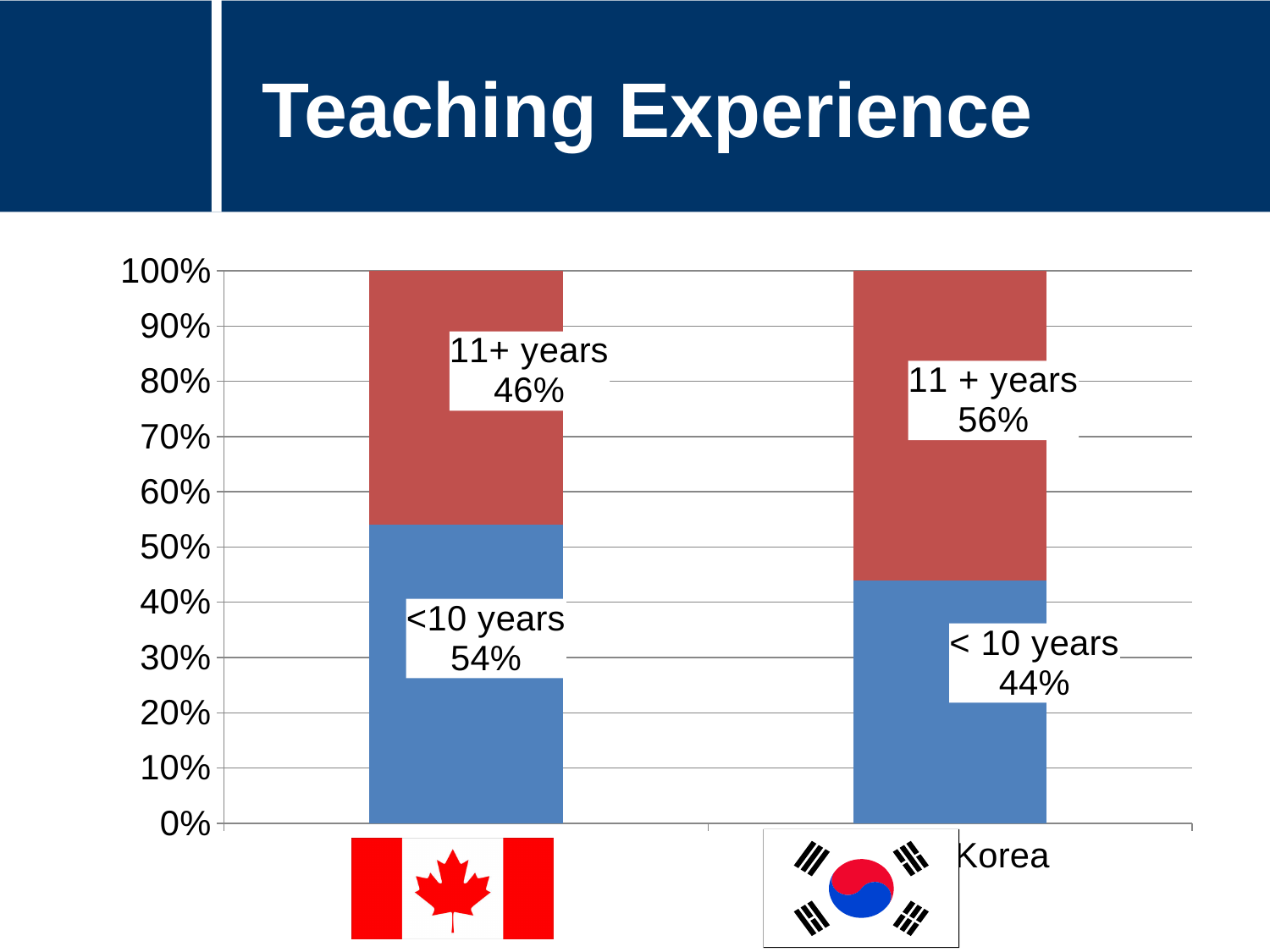
What is the difference between the '11 + years' share for Korea and the '11+ years' share for the left bar (Canadian flag)? 10% What is the title of the slide? Teaching Experience What percentage of the left bar (with the Canadian flag) is labelled '<10 years'? 54% What percentage of the Korea bar is labelled '< 10 years'? 44% In the left bar (with the Canadian flag), which segment is larger: '<10 years' or '11+ years'? <10 years What percentage of the Korea bar is labelled '11 + years'? 56% What is the total of the two segments in the Korea bar? 100% Is the '< 10 years' value for Korea greater or less than 50%? less What percentage of the left bar (with the Canadian flag) is labelled '11+ years'? 46% What kind of chart is shown on the slide? Stacked bar chart In the Korea bar, which segment is larger: '< 10 years' or '11 + years'? 11 + years How many bars are plotted in the chart? 2